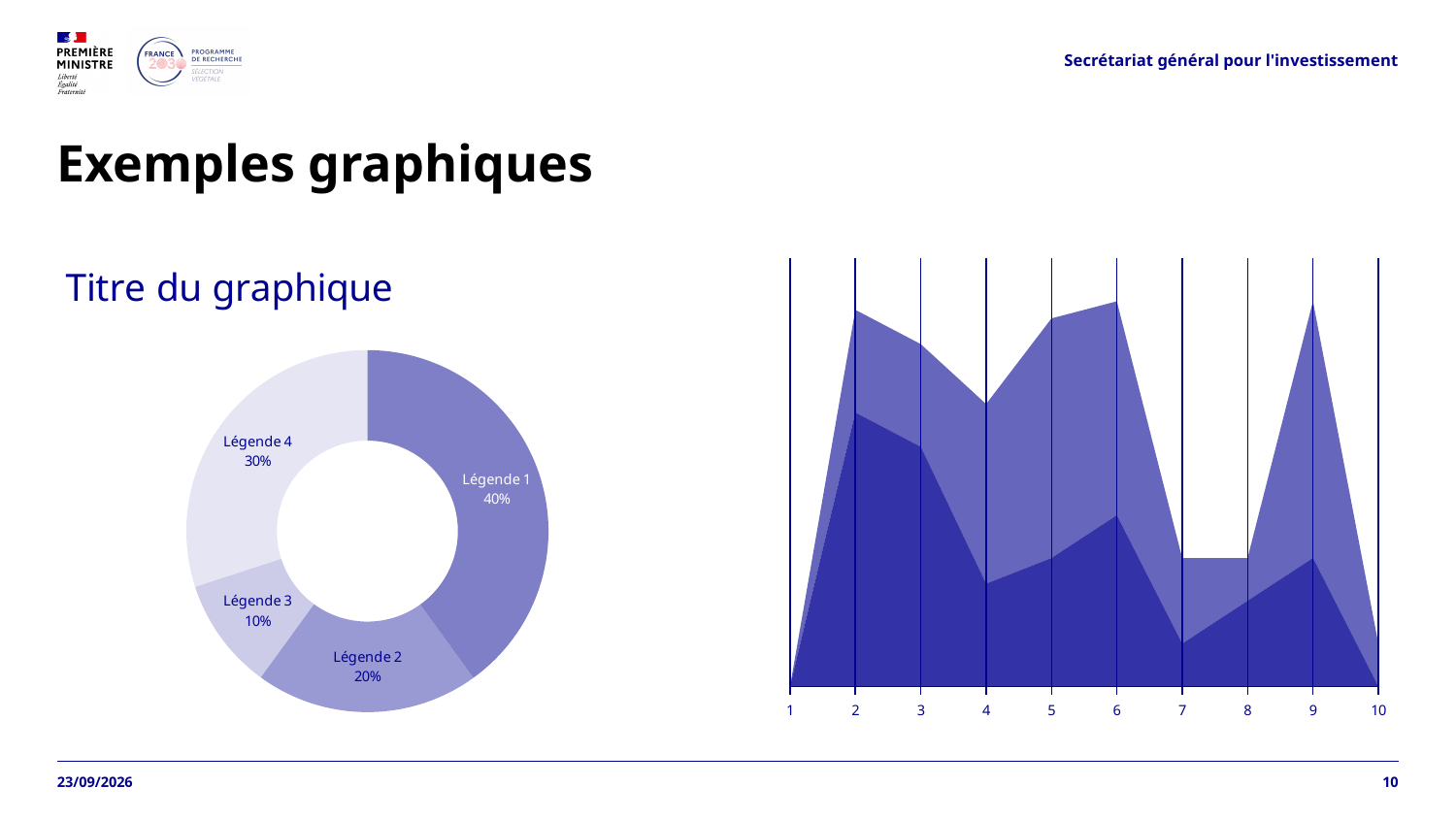
In the chart on the right side of the slide, how many points are labelled on the x axis? 10 In the chart titled "Titre du graphique", which category has the lowest value? Légende 3 In the chart titled "Titre du graphique", what is the value for Légende 1? 40% In the chart titled "Titre du graphique", which category has the highest value? Légende 1 What kind of chart is the one titled "Titre du graphique"? Doughnut chart In the chart on the right side of the slide, is the lower (darker) series higher at point 2 or at point 7? Point 2 In the chart titled "Titre du graphique", what is the value for Légende 3? 10% In the chart titled "Titre du graphique", how many categories are shown? 4 In the chart titled "Titre du graphique", what is the difference between Légende 4 and Légende 2? 10% In the chart titled "Titre du graphique", which is larger, Légende 4 or Légende 2? Légende 4 In the chart titled "Titre du graphique", what share of the whole does Légende 2 represent? 20% What kind of chart is shown on the right side of the slide? Area chart